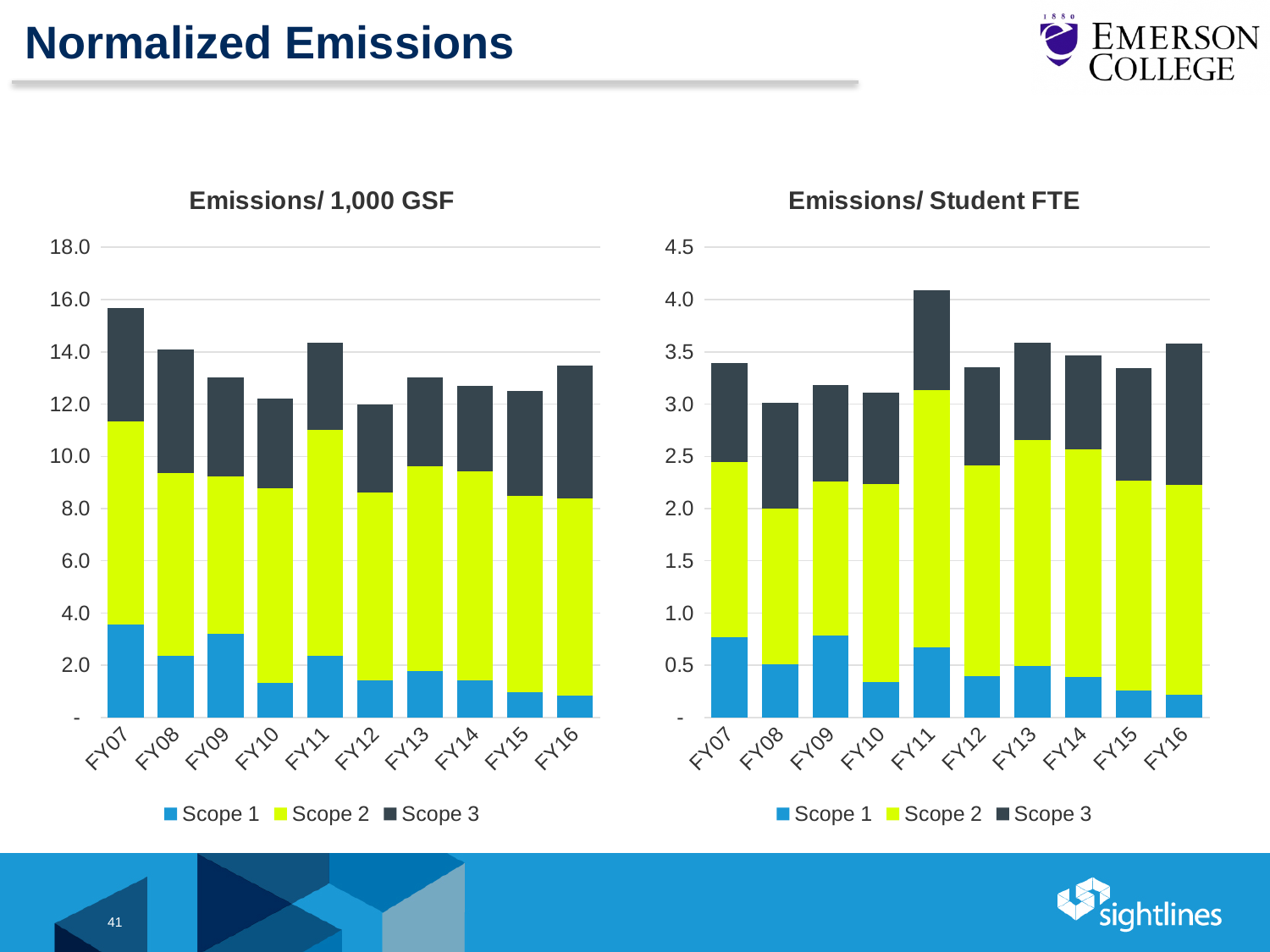
In the 'Emissions/ 1,000 GSF' chart, is the total bar for FY12 greater or less than 14.0? less What are the three legend entries of the 'Emissions/ Student FTE' chart? Scope 1, Scope 2, Scope 3 In the 'Emissions/ Student FTE' chart, is the total bar for FY08 greater or less than 3.5? less What type of chart is the 'Emissions/ 1,000 GSF' chart? Stacked bar chart In the 'Emissions/ Student FTE' chart, which total bar is taller, FY11 or FY07? FY11 In the 'Emissions/ 1,000 GSF' chart, is the total bar for FY07 greater or less than 14.0? greater How many fiscal years are shown on the x axis of the 'Emissions/ Student FTE' chart? 10 In the 'Emissions/ 1,000 GSF' chart, which fiscal year has the tallest total bar? FY07 In the 'Emissions/ Student FTE' chart, which fiscal year has the tallest total bar? FY11 In the 'Emissions/ 1,000 GSF' chart, which total bar is taller, FY07 or FY16? FY07 How many series does the legend of the 'Emissions/ 1,000 GSF' chart list? 3